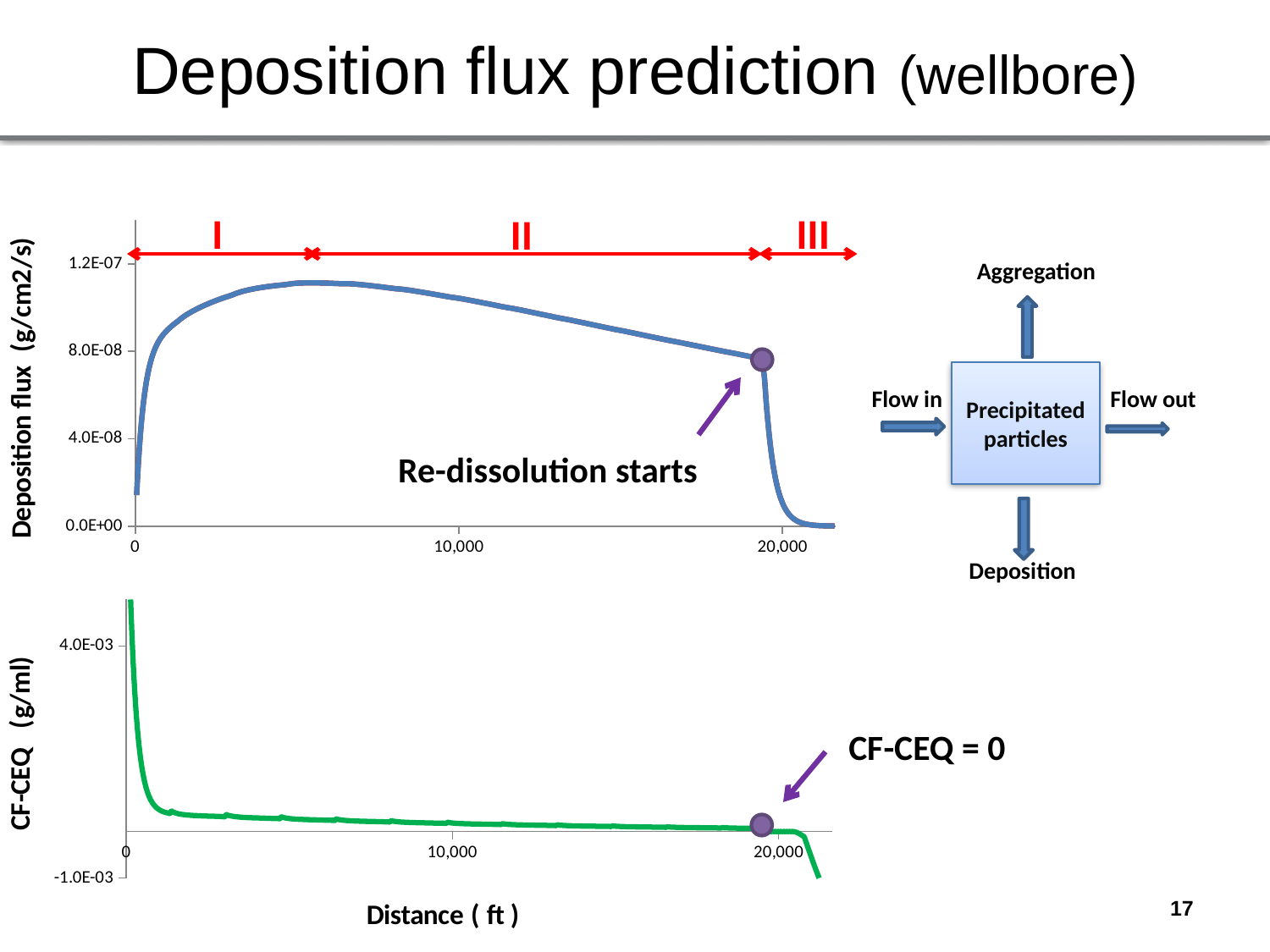
What kind of chart is the top chart (Deposition flux)? line chart What is the x-axis title shared by the two charts? Distance ( ft ) How many lines are plotted in the bottom chart? 1 In the bottom chart, does the CF-CEQ value rise or fall between 0 ft and 10,000 ft? fall What is the y-axis title of the top chart? Deposition flux (g/cm2/s) What kind of chart is the bottom chart (CF-CEQ)? line chart In the top chart, is the deposition flux at a distance of 20,000 ft greater or less than 4.0E-08? less In the top chart, is the peak deposition flux greater or less than 1.2E-07? less How many lines are plotted in the top chart? 1 In the top chart, is the deposition flux at a distance of 10,000 ft greater or less than 8.0E-08? greater In the top chart, does the deposition flux rise or fall between 10,000 ft and 20,000 ft? fall